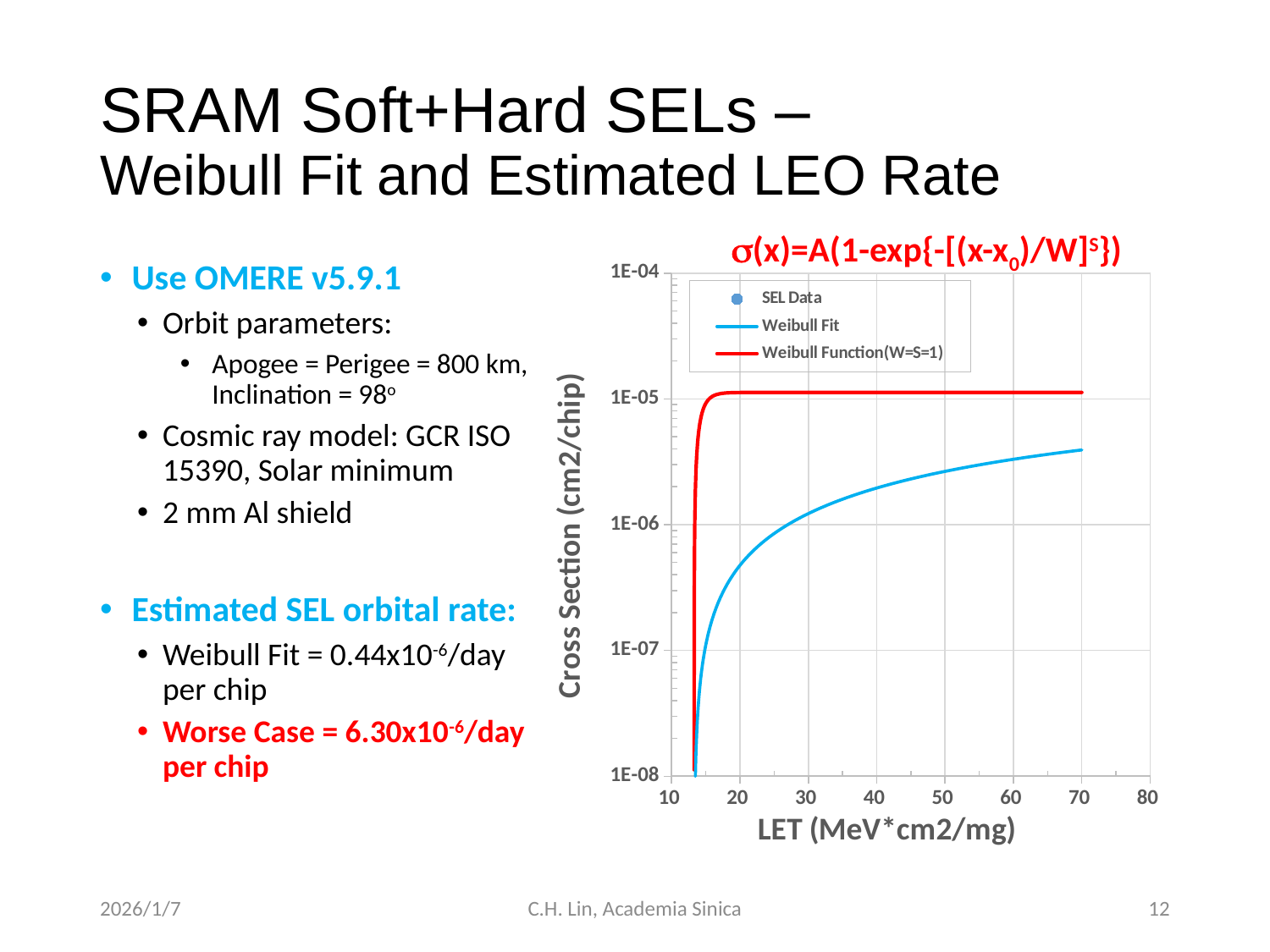
How many series does the chart legend list? 3 Is the Weibull Fit cross section at LET = 20 greater or less than 1E-06? less What kind of chart is shown on the slide? line chart What is the label of the y axis of the chart? Cross Section (cm2/chip) Is the Weibull Fit cross section at LET = 70 greater or less than 1E-05? less What is the label of the x axis of the chart? LET (MeV*cm2/mg) Which series is drawn in red in the chart? Weibull Function(W=S=1) Is the Weibull Fit cross section at LET = 70 greater or less than 1E-06? greater What is the highest value shown on the y axis of the chart? 1E-04 Does the Weibull Fit curve rise or fall as LET increases along the x axis? rise At LET = 50, which curve is higher: Weibull Fit or Weibull Function(W=S=1)? Weibull Function(W=S=1)